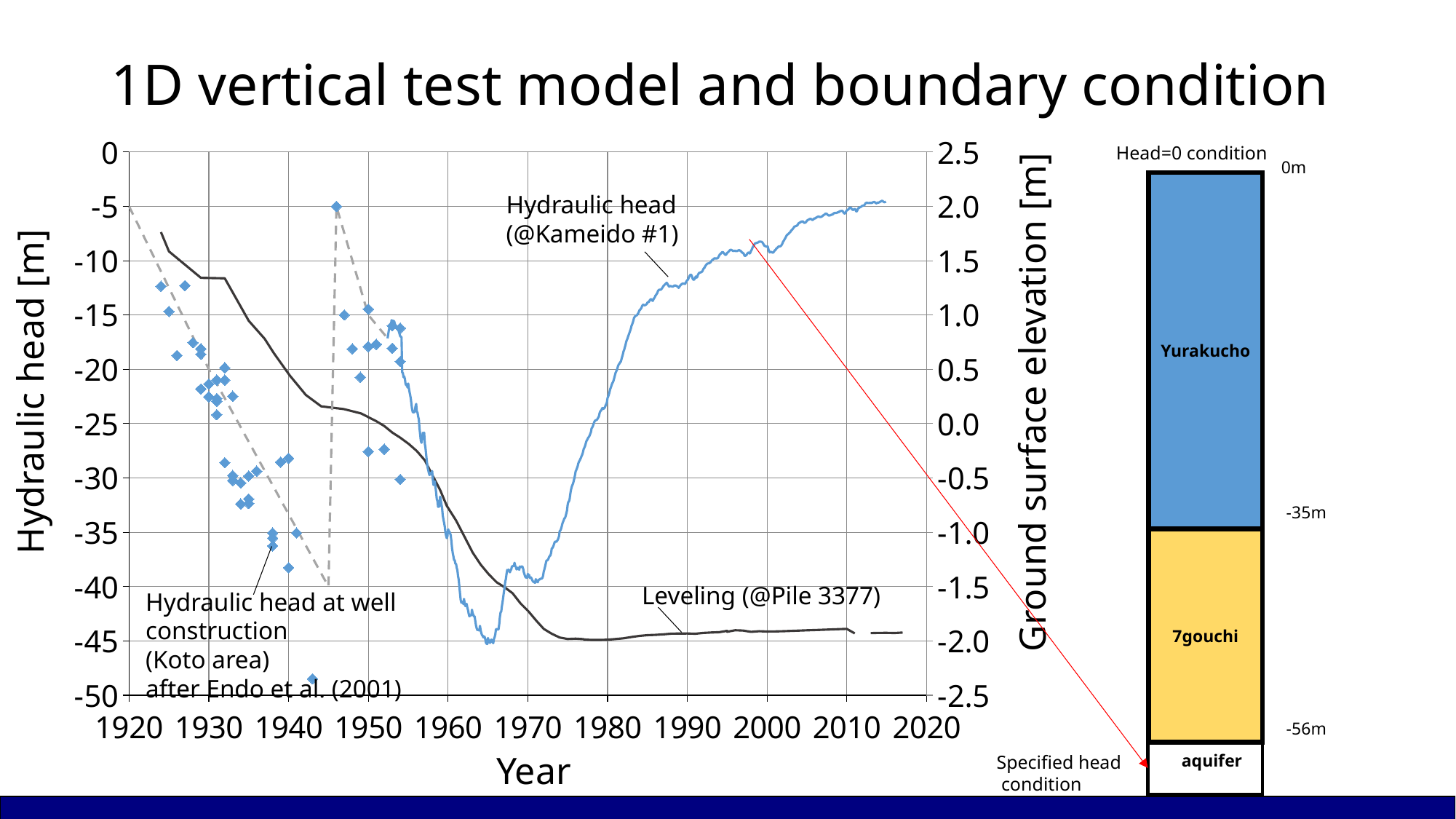
Is the leveling (@Pile 3377) ground surface elevation around 1980 greater or less than -1.5 m? less Does the hydraulic head (@Kameido #1) rise or fall between 1970 and 2010? rise How many year tick labels are shown on the x axis of the chart? 11 Which is larger, the hydraulic head (@Kameido #1) around 1950 or around 1965? around 1950 Does the leveling (@Pile 3377) line rise or fall between 1925 and 1975? fall What kind of chart is shown on the slide? line chart Is the hydraulic head (@Kameido #1) around 2010 greater or less than -10 m? greater What is the title of the right-hand y axis of the chart? Ground surface elevation [m] In which decade does the hydraulic head (@Kameido #1) reach its lowest value? 1960s Is the hydraulic head (@Kameido #1) around 1965 greater or less than -40 m? less What is the title of the x axis of the chart? Year